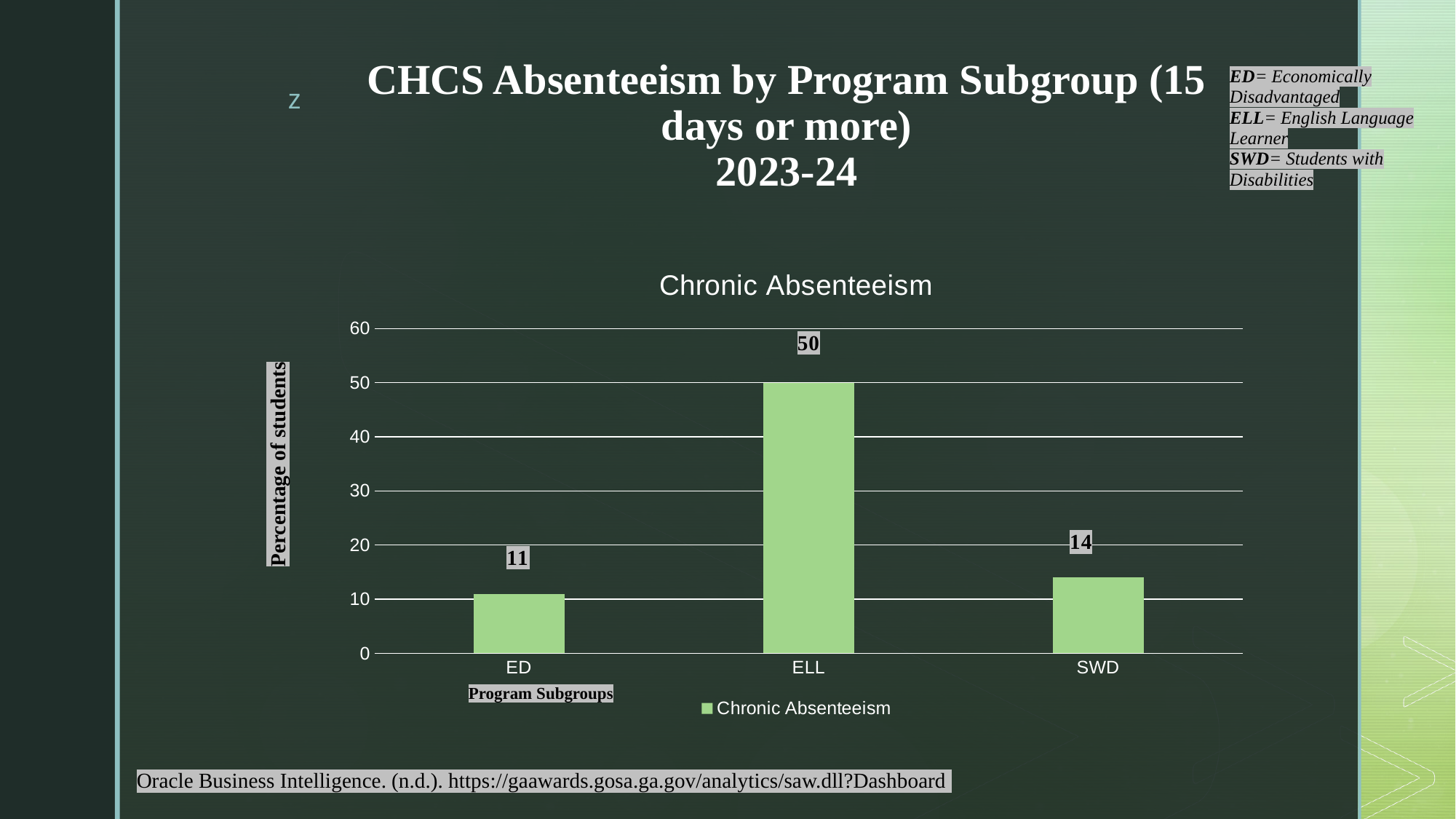
What is the chronic absenteeism value for ED? 11 How many series does the legend list? 1 What is the chronic absenteeism value for SWD? 14 What is the difference between the chronic absenteeism values for ELL and SWD? 36 What is the difference between the chronic absenteeism values for SWD and ED? 3 Which has a larger chronic absenteeism value, ED or SWD? SWD What is the chronic absenteeism value for ELL? 50 How many program subgroups are shown on the chart? 3 Which program subgroup has the lowest chronic absenteeism? ED Is the value for ELL greater or less than 40? greater What kind of chart is shown on the slide? bar chart Which program subgroup has the highest chronic absenteeism? ELL